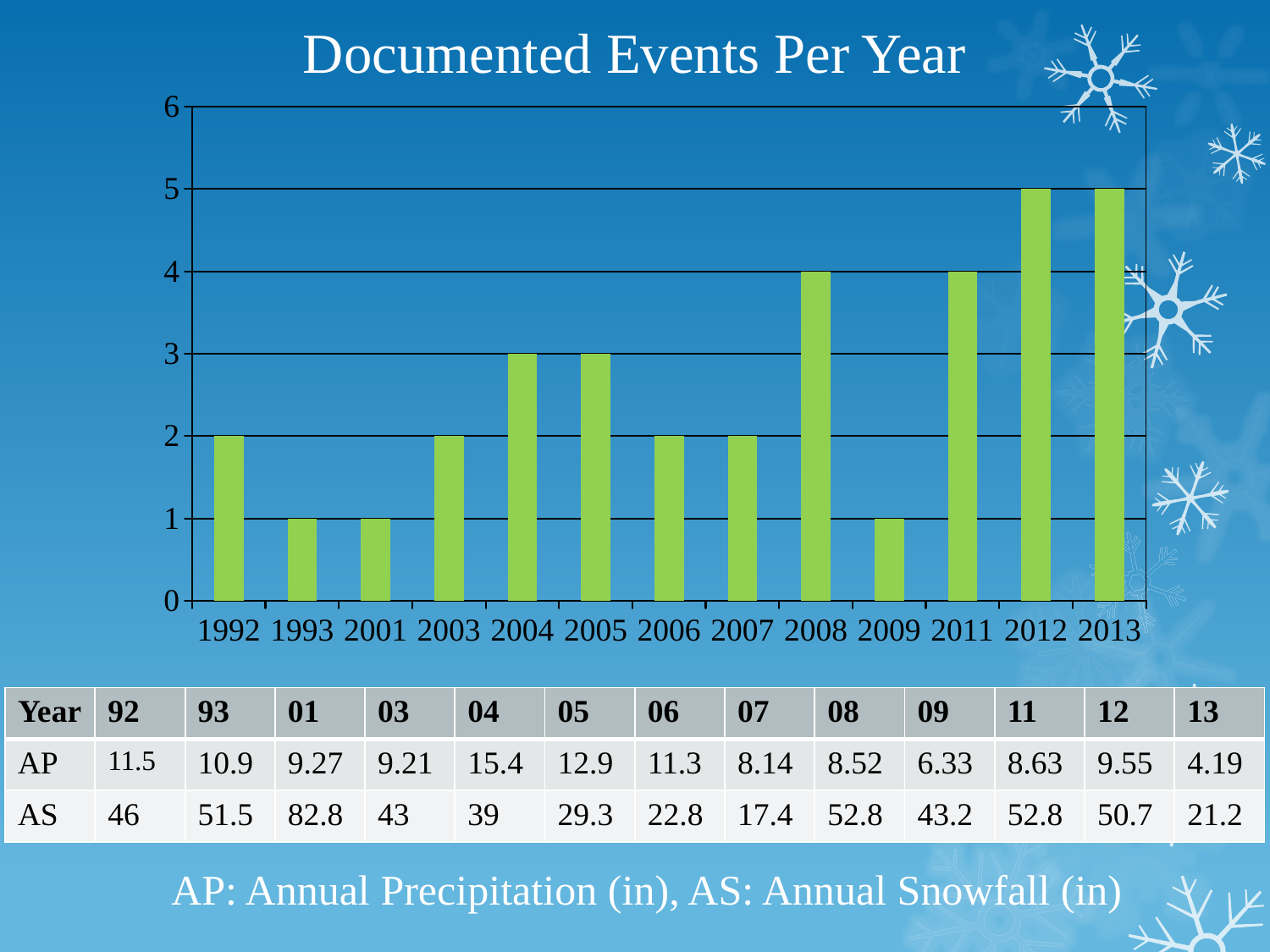
How many years are shown on the x axis of the chart? 13 What is the title of the chart? Documented Events Per Year What type of chart is shown on the slide? bar chart How many documented events are shown for 2008? 4 How many documented events are shown for 2009? 1 Which year has more documented events, 2008 or 2005? 2008 What is the difference between the number of events in 2012 and in 1992? 3 How many documented events are shown for 1992? 2 Which year has more documented events, 2011 or 2013? 2013 Is the value for 2004 greater or less than 2? greater How many documented events are shown for 2012? 5 How many documented events are shown for 2005? 3